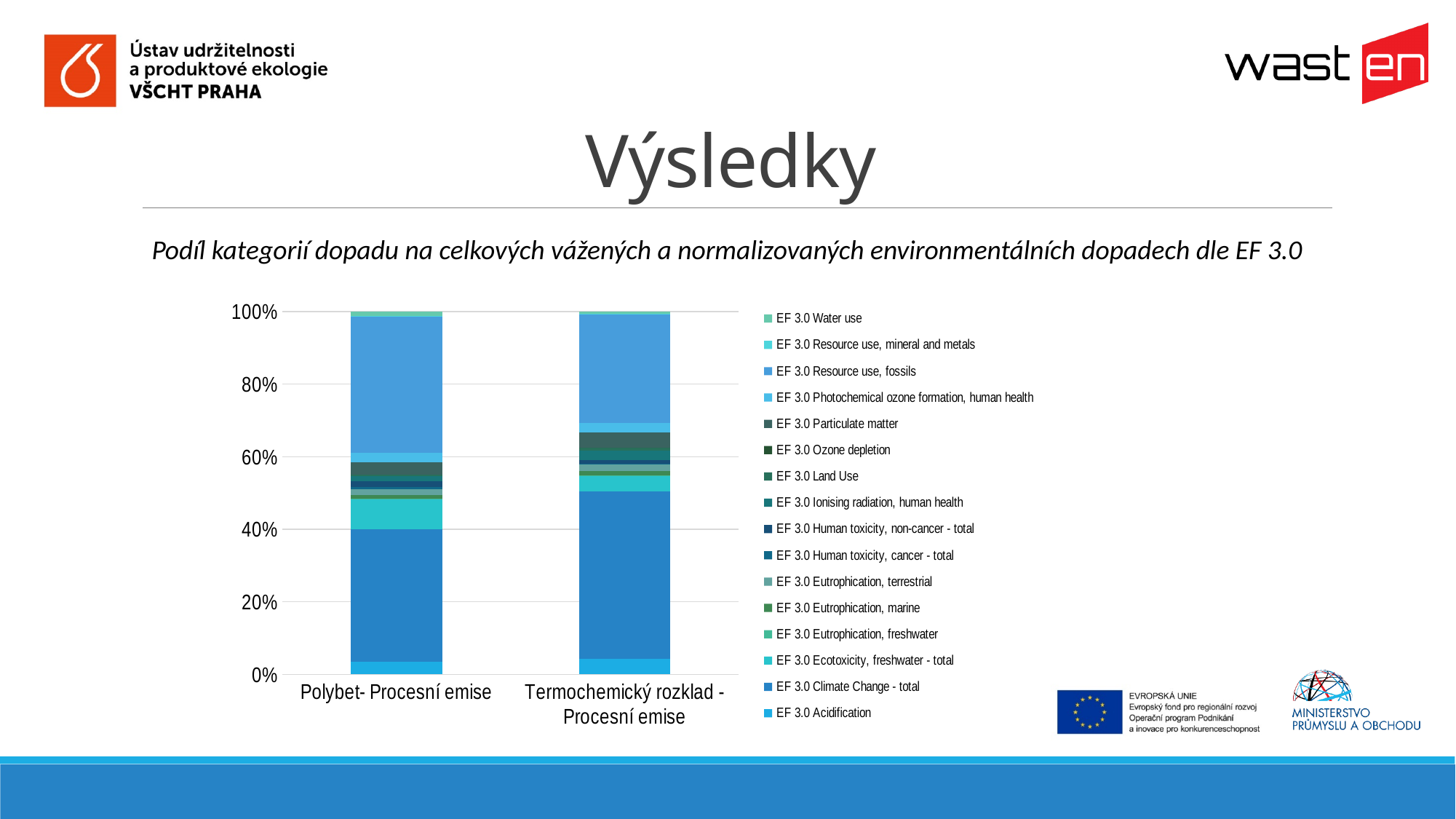
Which bar has the larger EF 3.0 Climate Change - total share, Polybet- Procesní emise or Termochemický rozklad - Procesní emise? Termochemický rozklad - Procesní emise Is the EF 3.0 Acidification share for Polybet- Procesní emise greater or less than 20%? less What are the two category labels on the x axis of the chart? Polybet- Procesní emise; Termochemický rozklad - Procesní emise Is the EF 3.0 Resource use, fossils share for Polybet- Procesní emise greater or less than 20%? greater Which series is listed last in the chart's legend? EF 3.0 Acidification What is the total height of the stacked bar for Polybet- Procesní emise? 100% What kind of chart is shown on the slide? bar chart How many categories (bars) are shown on the x axis of the chart? 2 How many series does the chart's legend list? 16 Is the EF 3.0 Climate Change - total share for Polybet- Procesní emise greater or less than 20%? greater